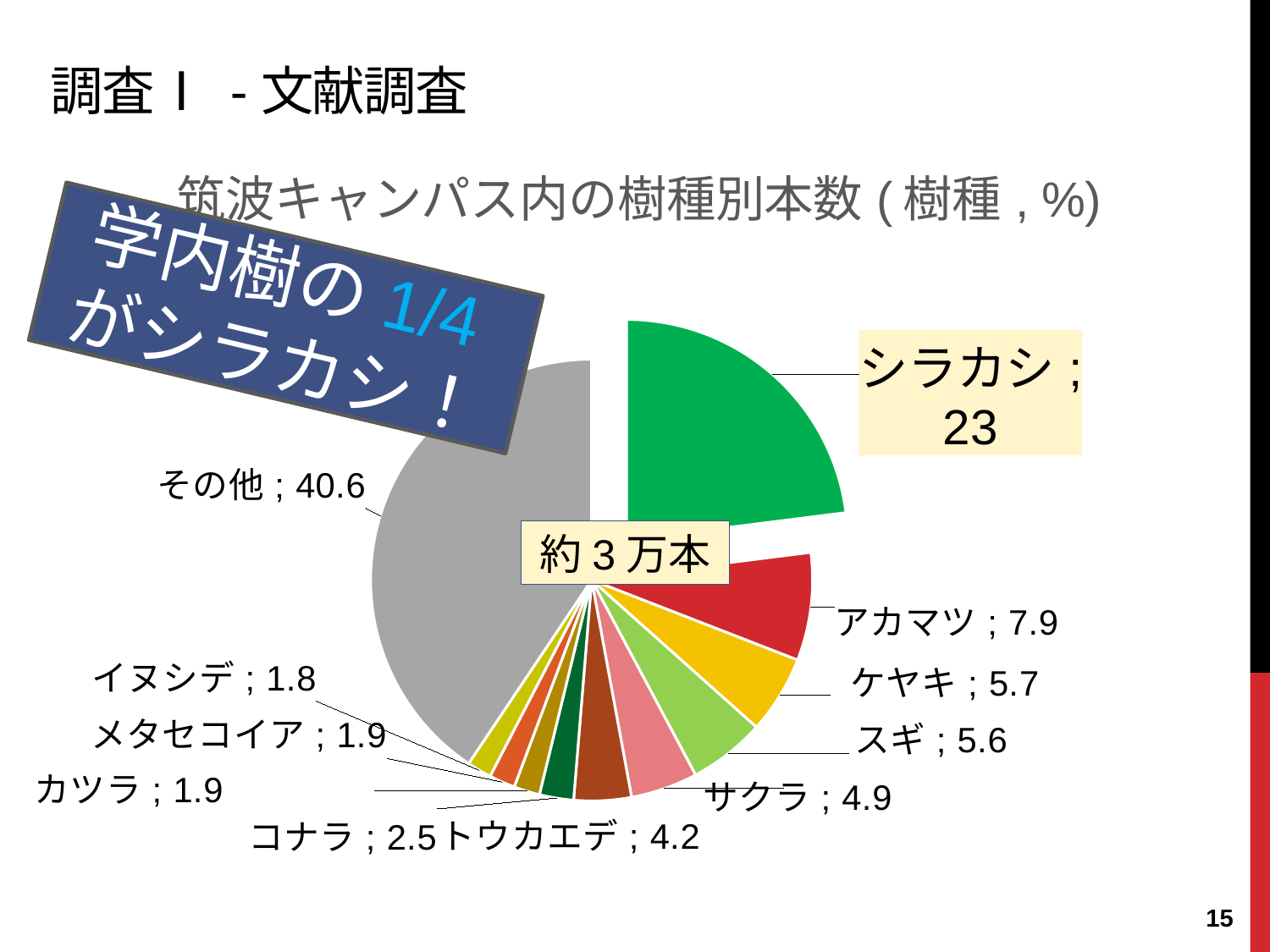
What share of the pie does シラカシ represent? 23% What is the difference between the values for シラカシ and アカマツ? 15.1 Which is larger, ケヤキ or スギ? ケヤキ What is the title of the pie chart? 筑波キャンパス内の樹種別本数 ( 樹種 , %) What is the value shown for シラカシ in the pie chart? 23 What kind of chart is shown on the slide? pie chart How many slices does the pie chart have? 11 What is the value shown for その他? 40.6 What is the value shown for トウカエデ? 4.2 Which slice of the pie chart is the largest? その他 What is the value shown for アカマツ? 7.9 Which slice of the pie chart is the smallest? イヌシデ